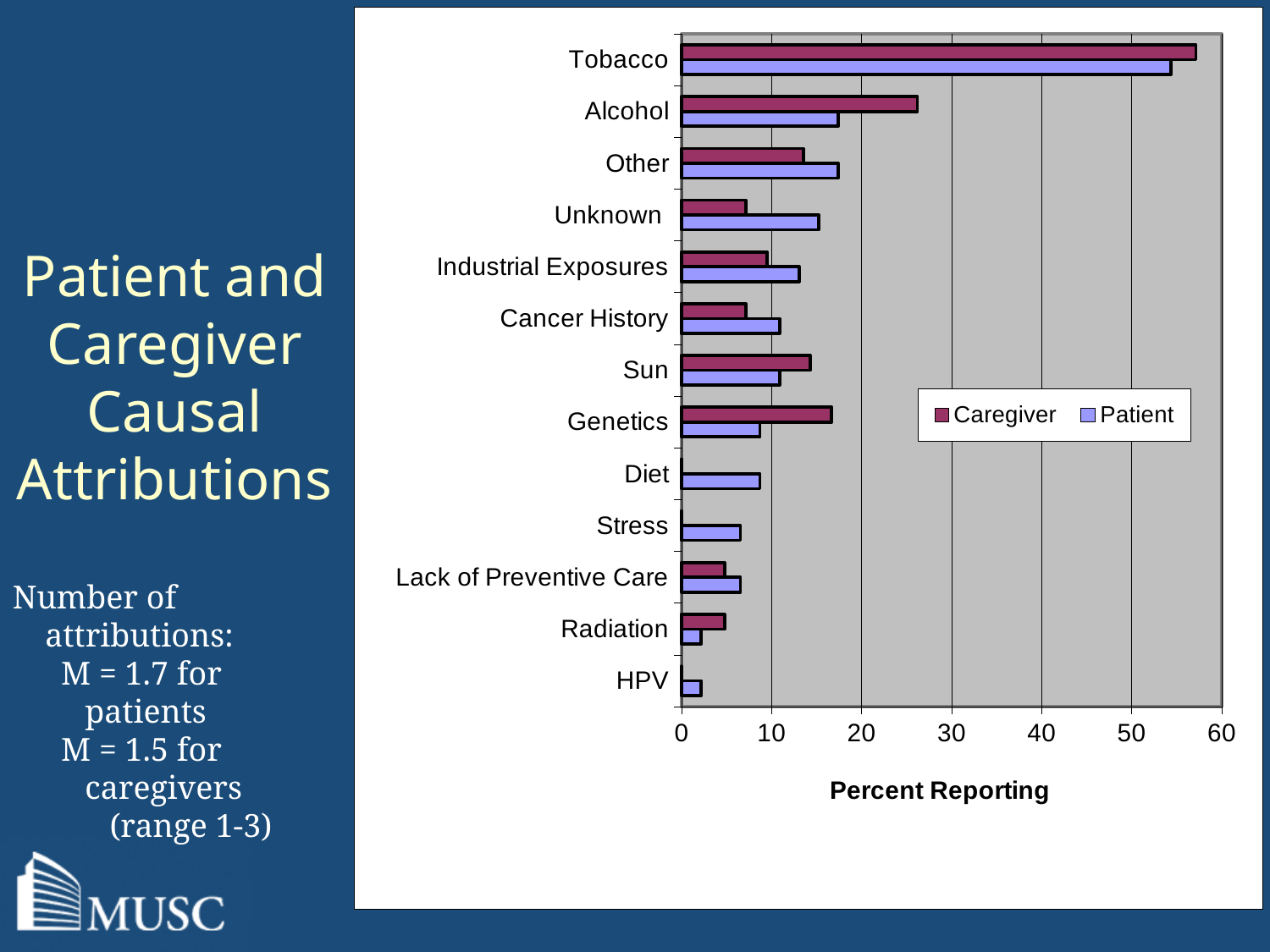
What is the title of the horizontal axis? Percent Reporting Is the Patient value for Genetics greater or less than 10? less How many causal attribution categories are plotted on the chart? 13 For Alcohol, which series has the larger value, Caregiver or Patient? Caregiver Is the Caregiver value for Alcohol greater or less than 20? greater What kind of chart is shown on the slide? bar chart How many series does the legend list? 2 For Genetics, which series has the larger value, Caregiver or Patient? Caregiver Which category has the highest Patient value? Tobacco Which category has the highest Caregiver value? Tobacco Is the Caregiver value for Tobacco greater or less than 50? greater For Unknown, which series has the larger value, Caregiver or Patient? Patient